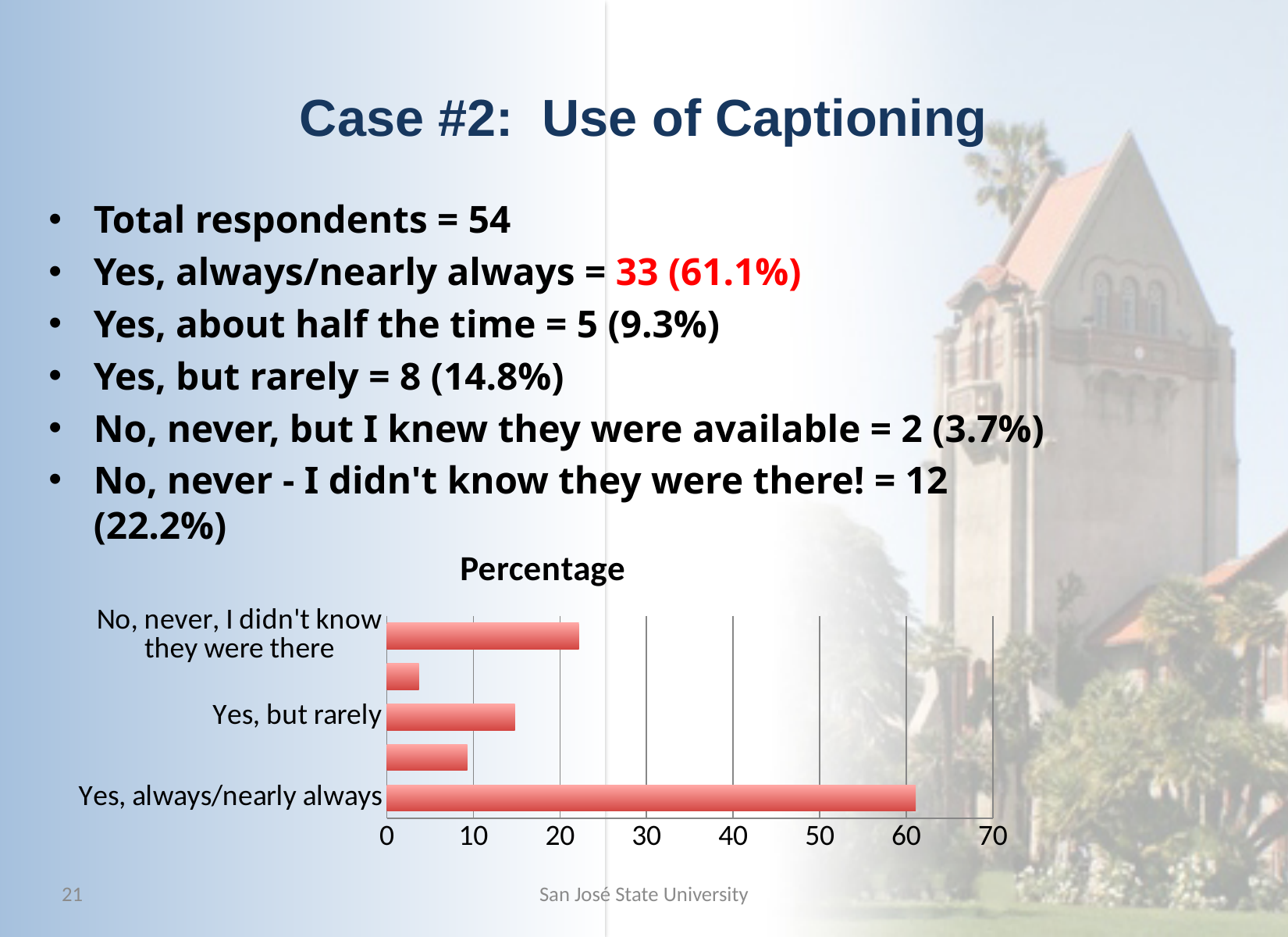
How many bars are plotted in the chart? 5 Is the value for "No, never, I didn't know they were there" greater or less than 30? less Which category has the longest bar in the chart? Yes, always/nearly always Is the value for "Yes, but rarely" greater or less than 20? less What kind of chart is shown on the slide? bar chart According to the slide, what percentage is plotted for "Yes, always/nearly always"? 61.1% Is the value for "Yes, always/nearly always" greater or less than 50? greater What is the title of the chart? Percentage What is the highest value shown on the chart's horizontal axis? 70 Which is larger: the bar for "Yes, always/nearly always" or the bar for "No, never, I didn't know they were there"? Yes, always/nearly always Which is larger: the bar for "Yes, but rarely" or the bar for "No, never, I didn't know they were there"? No, never, I didn't know they were there